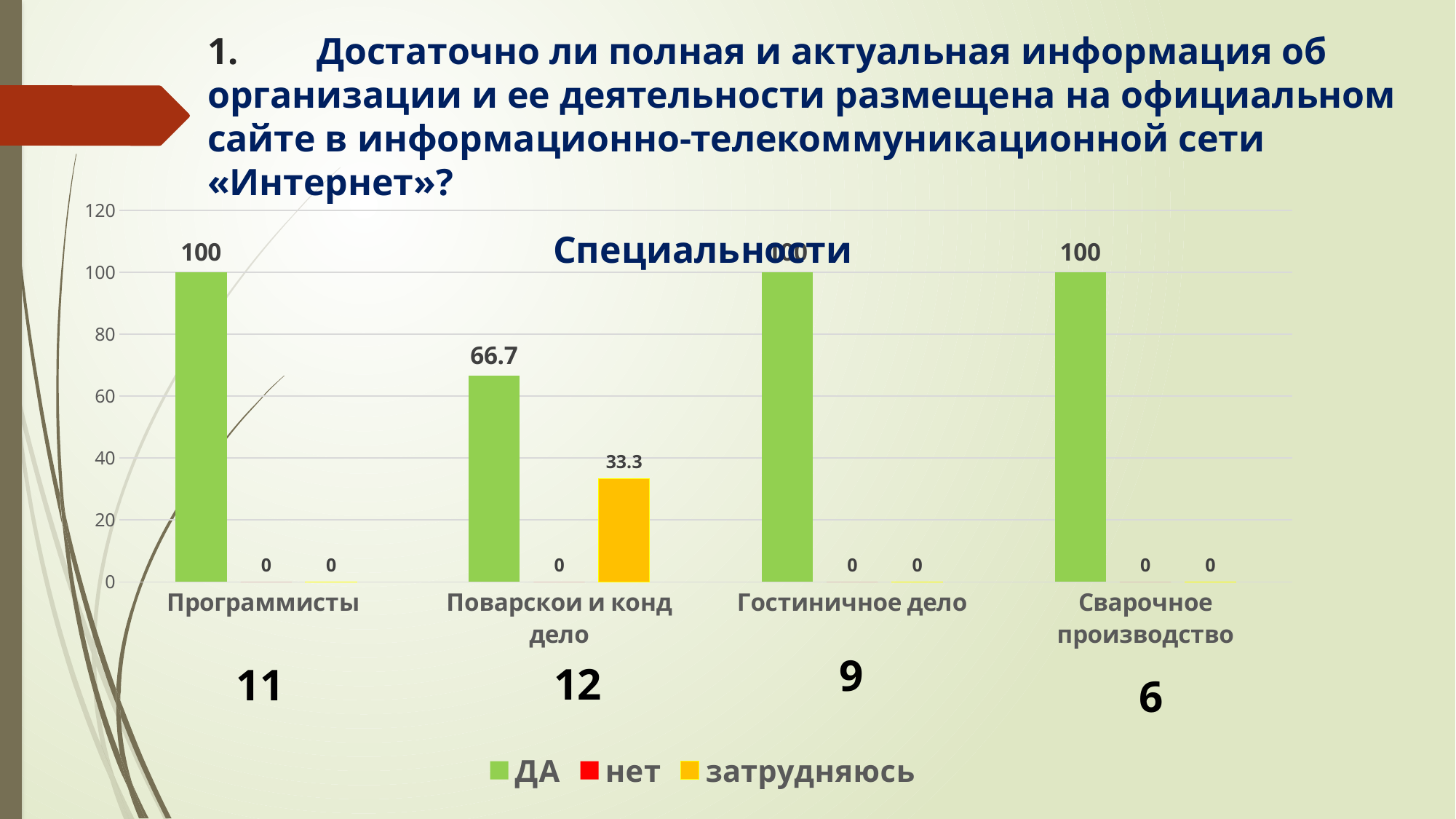
What is the value of ДА for Поварское и конд дело? 66.7 How many categories are shown on the x axis? 4 Which category has the lowest value for ДА? Поварское и конд дело What is the title of the chart? Специальности What is the difference between ДА and затрудняюсь for Поварское и конд дело? 33.4 What type of chart is shown on the slide? bar chart How many series does the legend list? 3 What is the value of затрудняюсь for Поварское и конд дело? 33.3 Which is larger for Поварское и конд дело: ДА or затрудняюсь? ДА Which legend entry is shown in yellow? затрудняюсь What is the value of ДА for Программисты? 100 What is the value of нет for Сварочное производство? 0